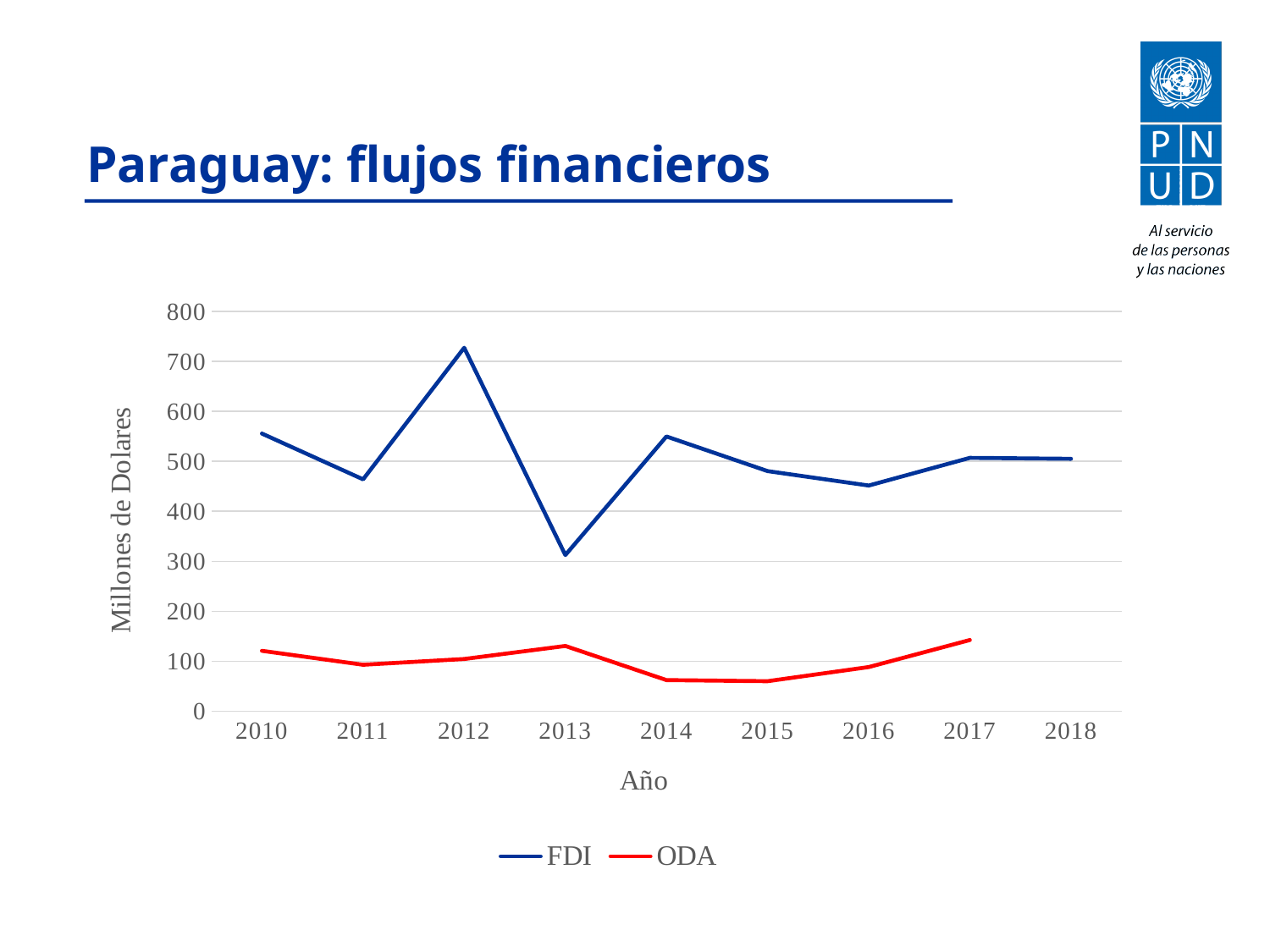
How many series does the legend list? 2 What is the label of the y axis? Millones de Dolares Is the ODA value for 2014 greater or less than 100? less Which is larger, FDI in 2010 or FDI in 2011? FDI in 2010 Is the FDI value for 2013 greater or less than 400? less In which year does FDI reach its lowest value? 2013 In which year does FDI reach its highest value? 2012 What kind of chart is shown on the slide? line chart How many years are shown on the x axis? 9 In which year does ODA reach its highest value? 2017 Does ODA rise or fall from 2015 to 2017? rise Is the FDI value for 2012 greater or less than 700? greater